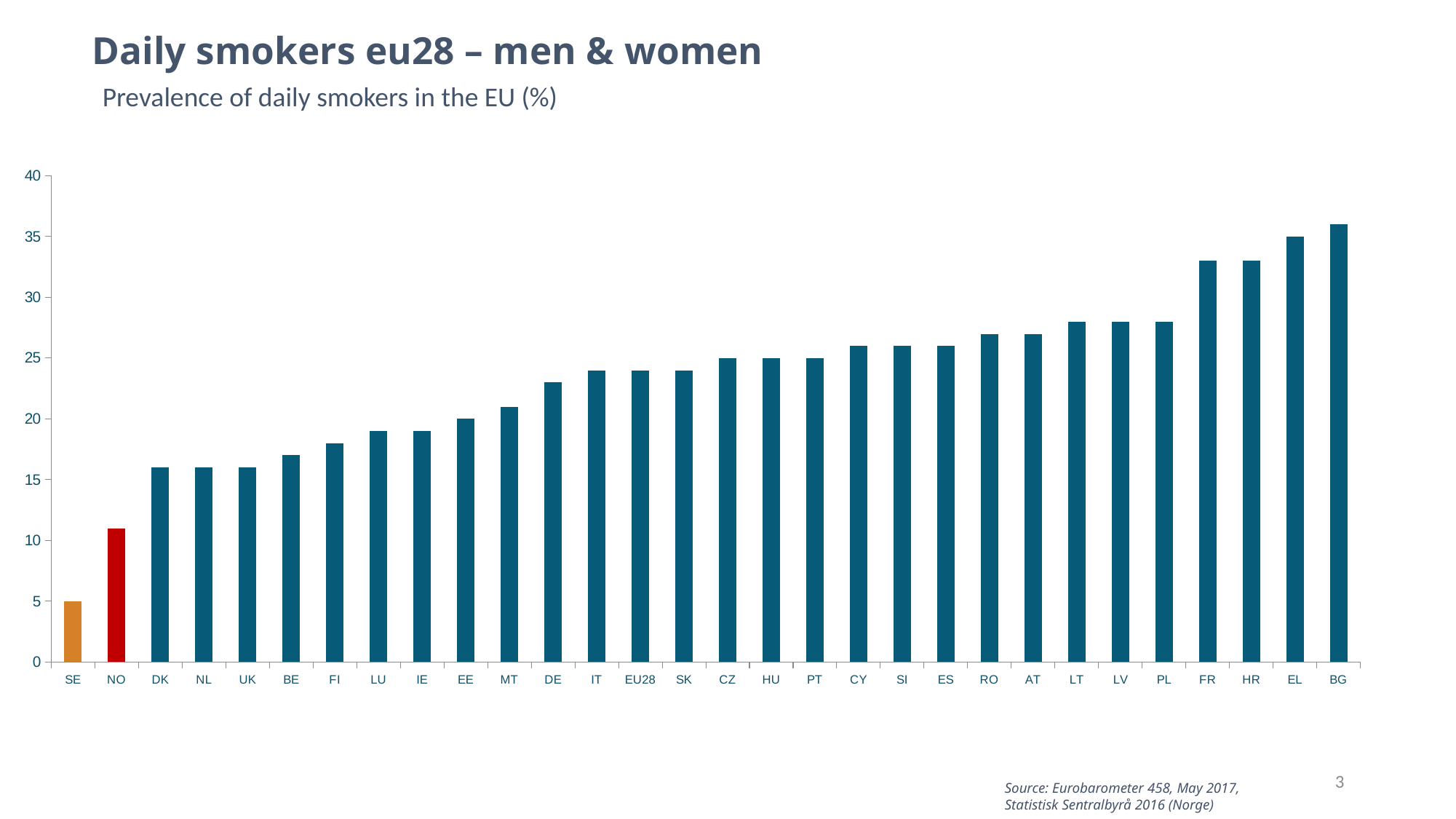
Which country has the highest prevalence of daily smokers? BG Which is larger, the value for FR or the value for DK? FR What is the value for EL? 35 Do the values rise or fall from left to right along the x axis? rise What is the value for SE? 5 Is the value for BG greater or less than 35? greater What kind of chart is shown on the slide? bar chart How many categories are shown on the x axis? 30 What is the value for EE? 20 Which country has the lowest prevalence of daily smokers? SE Is the value for NO greater or less than 15? less Is the value for DE greater or less than 25? less